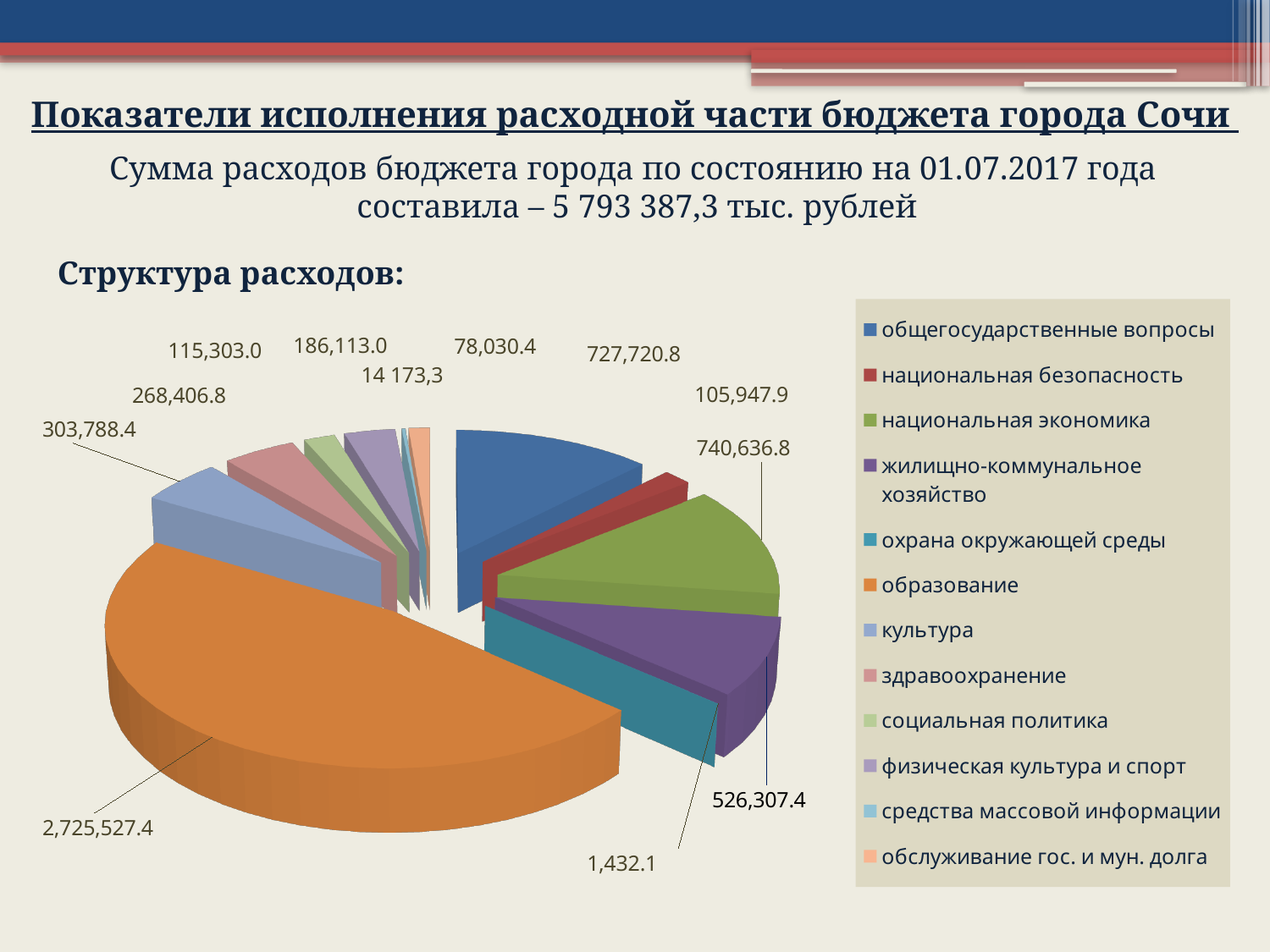
What is the difference between the values for национальная экономика and общегосударственные вопросы? 12,916.0 What is the heading printed above the pie chart? Структура расходов: Which is larger: образование or национальная экономика? образование What is the value shown for общегосударственные вопросы? 727,720.8 What is the value shown for национальная экономика? 740,636.8 What is the value shown for жилищно-коммунальное хозяйство? 526,307.4 What is the value shown for образование? 2,725,527.4 What colour represents образование in the pie chart? orange Which category has the largest slice in the pie chart? образование What kind of chart is shown on the slide? pie chart How many categories does the legend of the pie chart list? 12 Which category has the smallest value in the pie chart? охрана окружающей среды